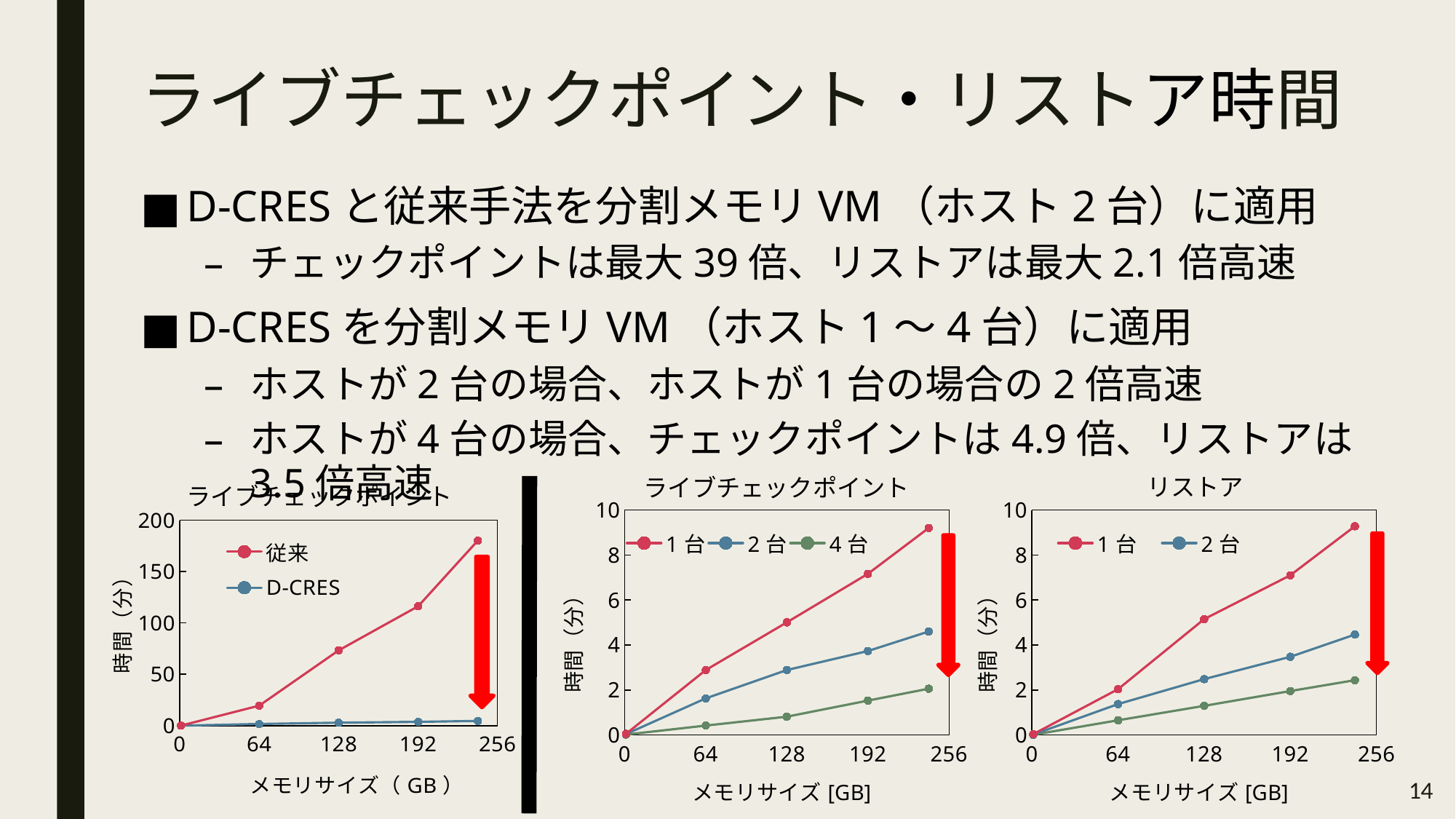
In the leftmost chart, is the value for D-CRES at the largest memory size greater or less than 50? less In the middle chart, is the value for 2 台 at 128 GB greater or less than 4? less In the leftmost chart (ライブチェックポイント, 従来 vs D-CRES), how many series does the legend list? 2 In the leftmost chart, is the value for 従来 at the largest memory size greater or less than 150? greater In the leftmost chart, what kind of chart is shown? line chart In the leftmost chart, which series has the higher value at 192 GB, 従来 or D-CRES? 従来 In the middle chart, which series has the lowest value at the largest memory size? 4 台 In the middle chart (ライブチェックポイント with 1台/2台/4台), how many series does the legend list? 3 In the rightmost chart (リストア), do the values for 1 台 rise or fall as memory size increases? rise In the rightmost chart (リストア), how many series does the legend list? 2